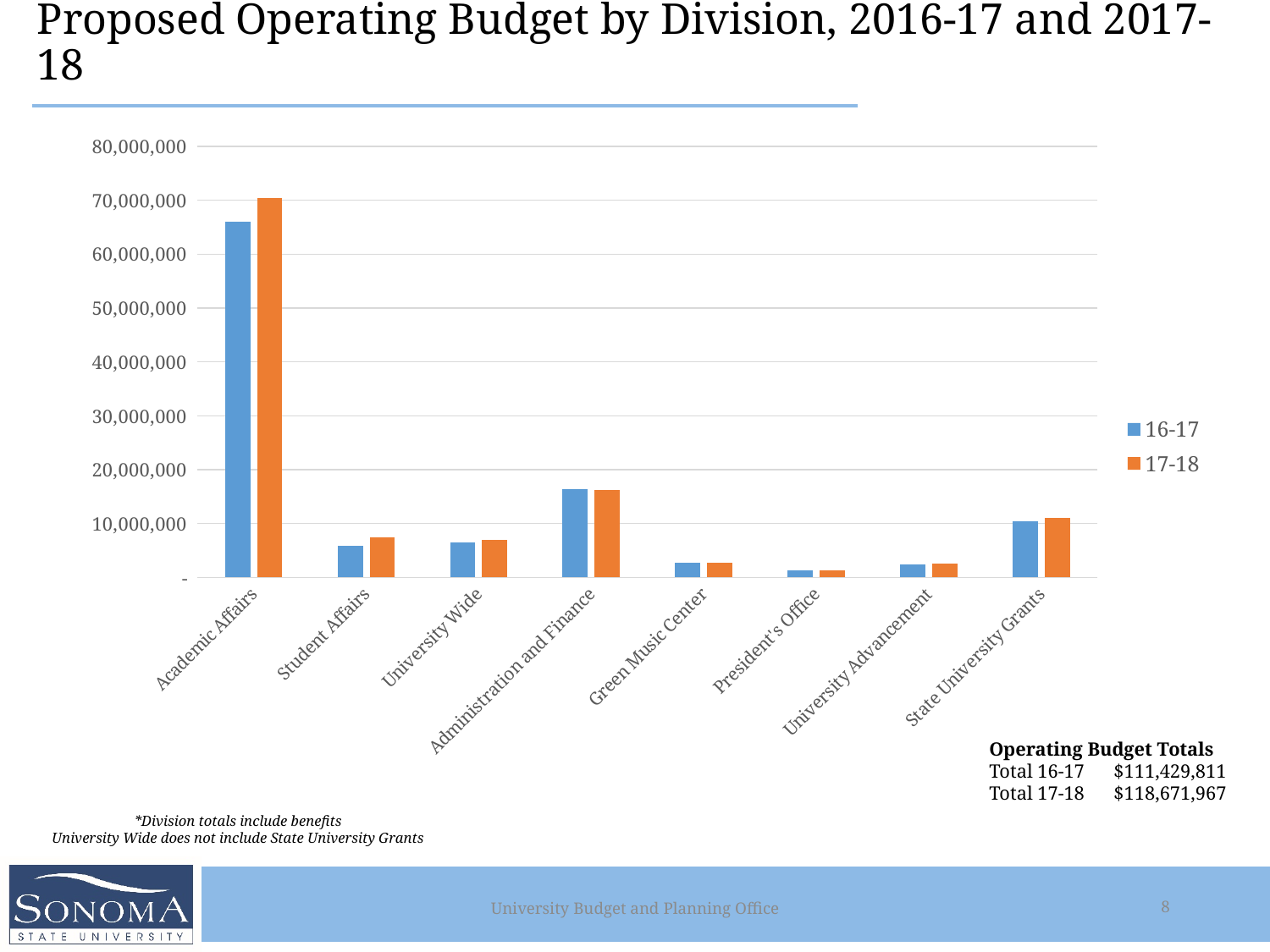
Is the 17-18 value for Student Affairs greater or less than 10,000,000? less Which division has the highest proposed operating budget in 17-18? Academic Affairs In 16-17, which division has the larger budget, Administration and Finance or State University Grants? Administration and Finance Is the 16-17 value for Academic Affairs greater or less than 60,000,000? greater Is the 16-17 value for Administration and Finance greater or less than 10,000,000? greater Which division has the lowest proposed operating budget in 16-17? President's Office How many divisions are shown on the x axis of the chart? 8 What are the two entries in the chart's legend? 16-17 and 17-18 How many series does the chart's legend list? 2 What kind of chart is shown on the slide? bar chart For Academic Affairs, which year has the larger budget, 16-17 or 17-18? 17-18